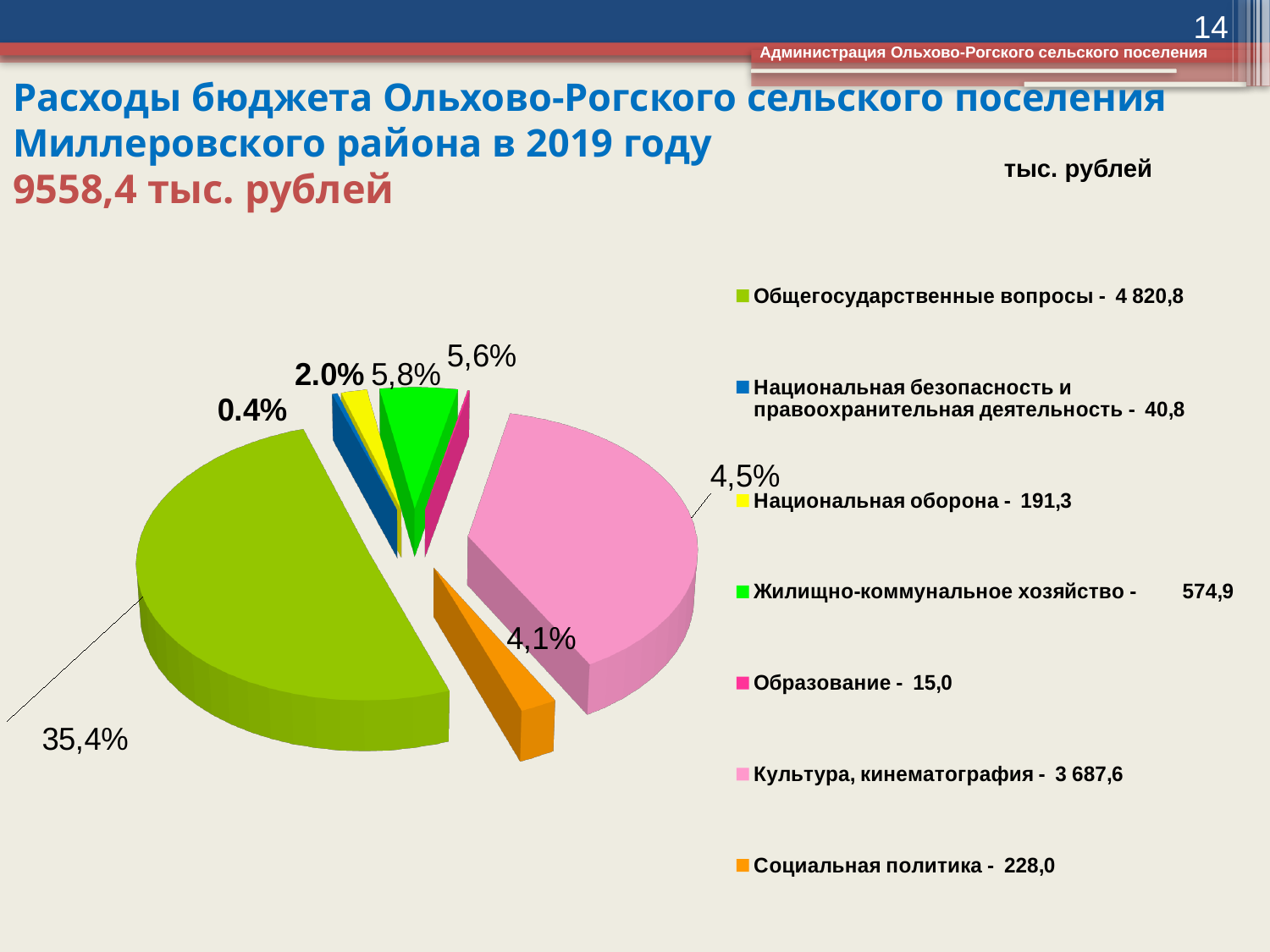
What is the difference between the values for Общегосударственные вопросы and Культура, кинематография? 1 133,2 How many categories does the legend of the pie chart list? 7 What kind of chart is shown on the slide? pie chart Which category has the largest value in the pie chart? Общегосударственные вопросы What value is given in the legend for Национальная оборона? 191,3 Which is larger: the value for Жилищно-коммунальное хозяйство or for Социальная политика? Жилищно-коммунальное хозяйство What value is given in the legend for Культура, кинематография? 3 687,6 What colour represents Культура, кинематография in the pie chart? pink What value is given in the legend for Социальная политика? 228,0 What total budget expenditure is stated in the slide title? 9558,4 тыс. рублей Which category has the smallest value in the pie chart? Образование What value is given in the legend for Общегосударственные вопросы? 4 820,8